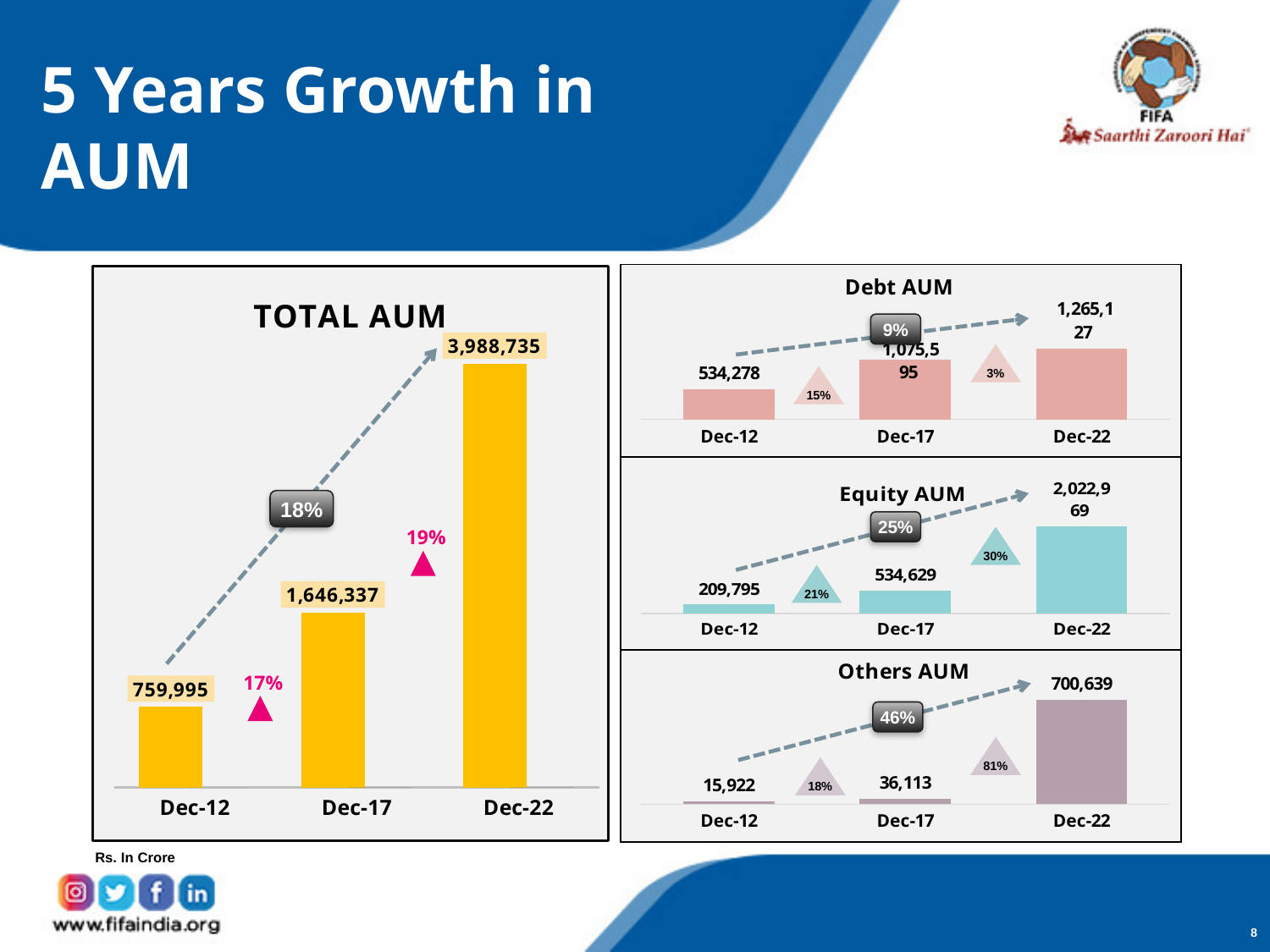
In the TOTAL AUM chart, what is the difference between the Dec-17 and Dec-12 values? 886,342 In the Equity AUM chart, what is the difference between the Dec-17 and Dec-12 values? 324,834 In the TOTAL AUM chart, which period has the highest value? Dec-22 How many periods are shown on the x axis of the Others AUM chart? 3 In the Others AUM chart, what is the value for Dec-22? 700,639 In the TOTAL AUM chart, what is the value for Dec-22? 3,988,735 In the TOTAL AUM chart, what is the value for Dec-12? 759,995 In the Debt AUM chart, what growth percentage is shown between Dec-17 and Dec-22? 3% In the Equity AUM chart, what is the value for Dec-17? 534,629 In the Debt AUM chart, what is the value for Dec-12? 534,278 In the Others AUM chart, which period has the lowest value? Dec-12 What kind of chart is the TOTAL AUM chart? Bar chart